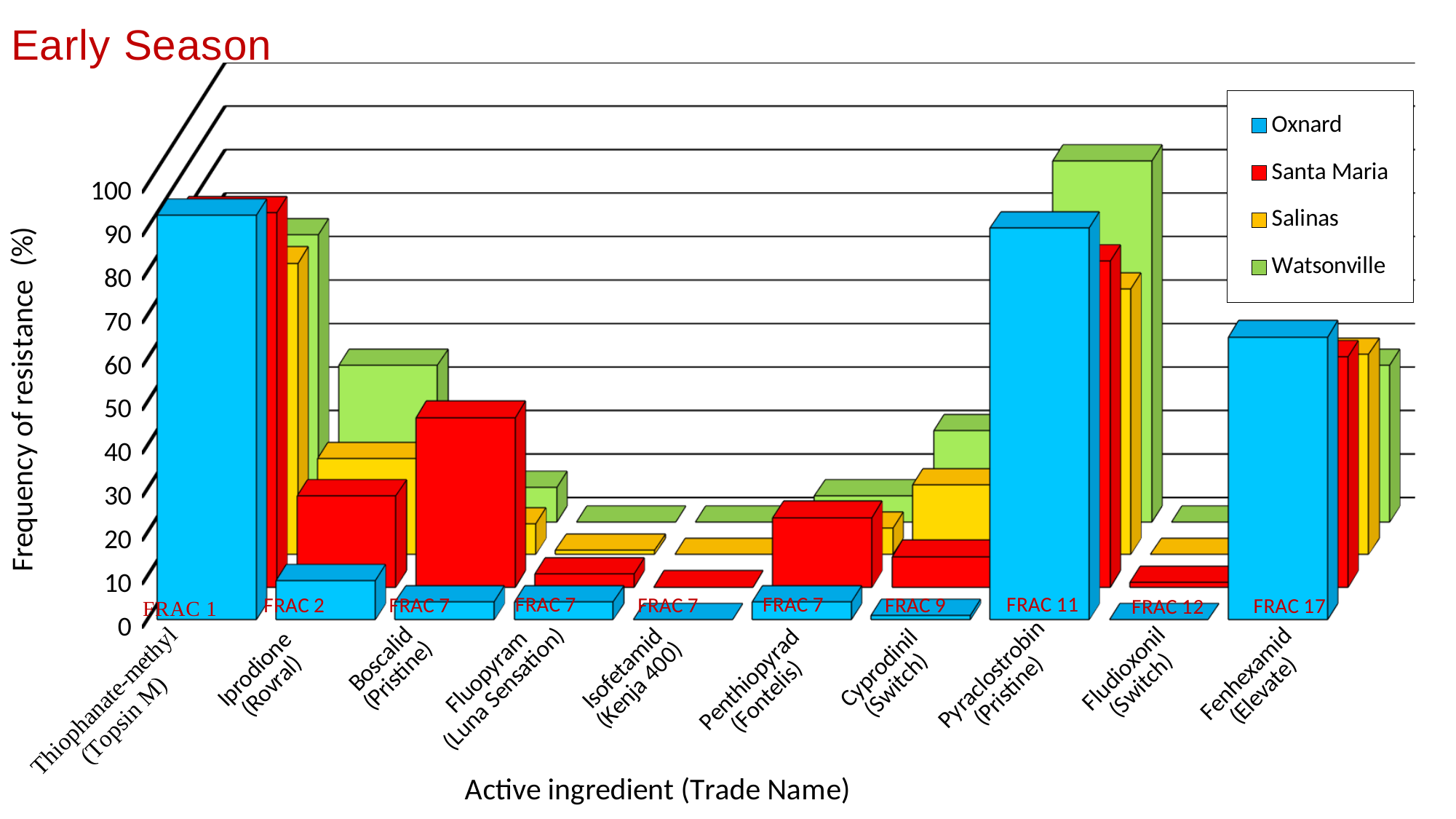
Which is larger, the Santa Maria value for Boscalid (Pristine) or the Santa Maria value for Iprodione (Rovral)? Boscalid (Pristine) What is the title of the chart? Early Season Is the Oxnard value for Fenhexamid (Elevate) greater or less than 40? greater Which is larger, the Oxnard value for Thiophanate-methyl (Topsin M) or the Oxnard value for Iprodione (Rovral)? Thiophanate-methyl (Topsin M) Is the Oxnard value for Iprodione (Rovral) greater or less than 30? less How many series does the legend list? 4 Is the Santa Maria value for Boscalid (Pristine) greater or less than 30? greater How many active ingredients (categories) are plotted along the x axis? 10 What kind of chart is shown on the slide? bar chart What is the label of the y axis? Frequency of resistance (%)